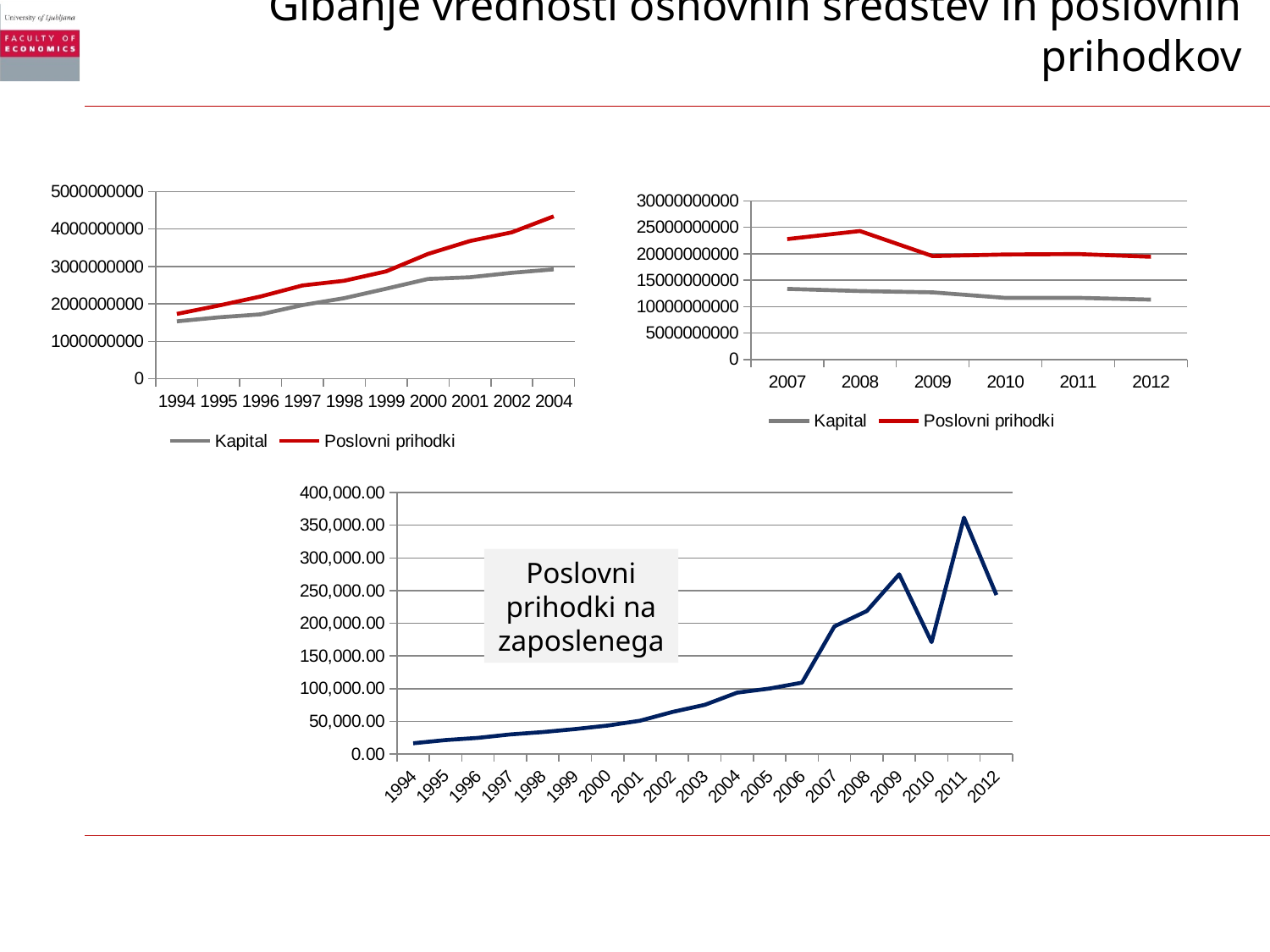
In the top-right chart (2007–2012), which series has the larger value in 2012, Kapital or Poslovni prihodki? Poslovni prihodki In the bottom chart 'Poslovni prihodki na zaposlenega', which year has the highest value? 2011 What kind of chart is the bottom chart titled 'Poslovni prihodki na zaposlenega'? line chart In the top-left chart (1994–2004), how many years are shown on the x axis? 10 In the bottom chart 'Poslovni prihodki na zaposlenega', is the value for 2010 greater or less than 200,000.00? less In the top-left chart (1994–2004), does Poslovni prihodki rise or fall from 1994 to 2004? rise In the top-right chart (2007–2012), is the value of Kapital in 2007 greater or less than 15000000000? less In the bottom chart 'Poslovni prihodki na zaposlenega', how many years are shown on the x axis? 19 In the top-left chart (1994–2004), is the value of Kapital in 1994 greater or less than 2000000000? less In the top-left chart (1994–2004), how many series does the legend list? 2 In the top-right chart (2007–2012), which year has the highest value for Poslovni prihodki? 2008